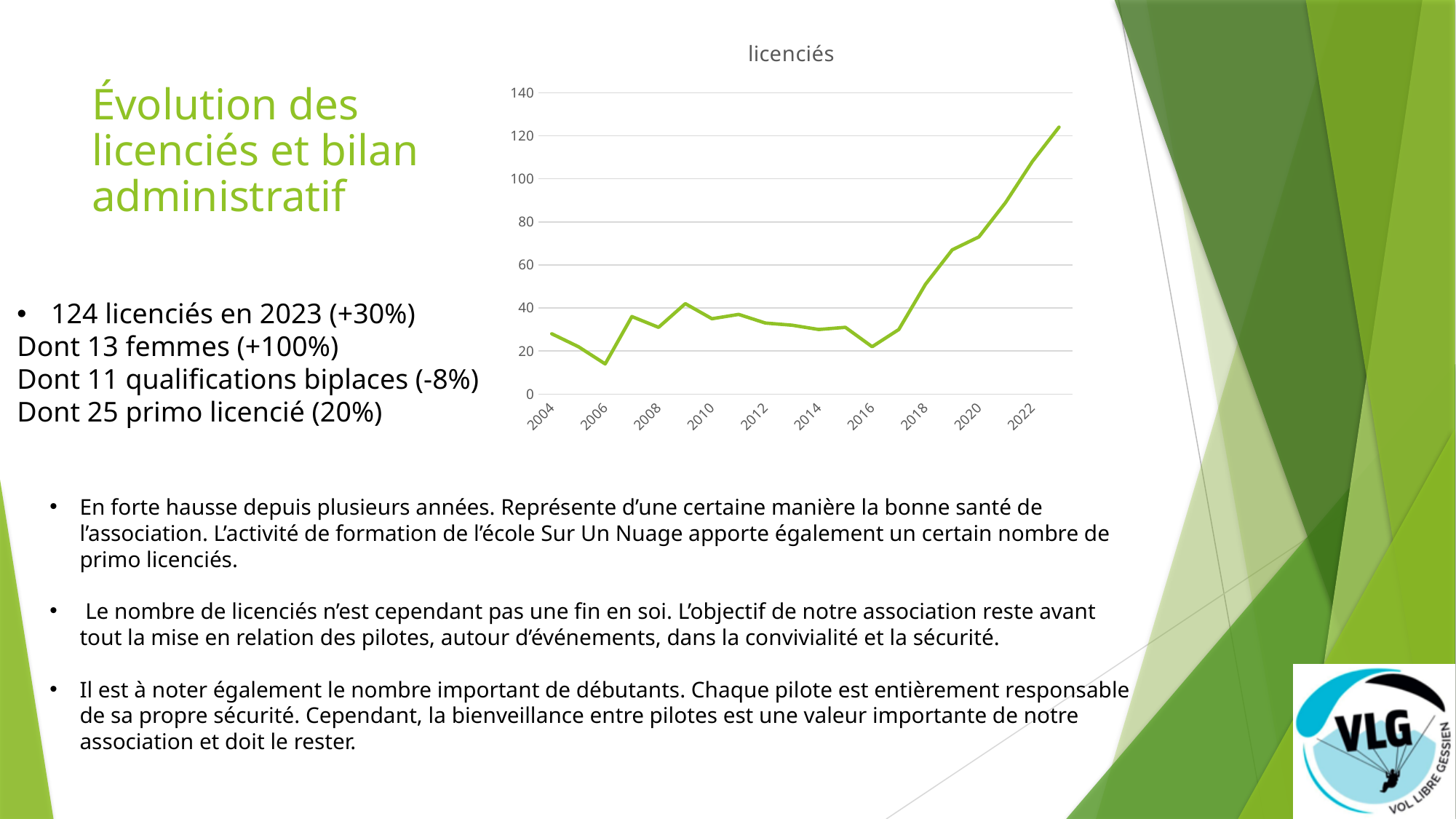
Which has the larger value, 2004 or 2006? 2004 Which has the larger value, 2010 or 2020? 2020 What is the highest value shown on the y axis? 140 What is the title of the chart? licenciés Is the value for 2006 greater or less than 20? less What kind of chart is shown on the slide? line chart Does the line rise or fall between 2016 and the end of the series? rise Is the value for 2004 greater or less than 40? less How many year labels are shown on the x axis? 10 Which year labelled on the x axis has the lowest value in the chart? 2006 Is the value at the last point of the line greater or less than 100? greater